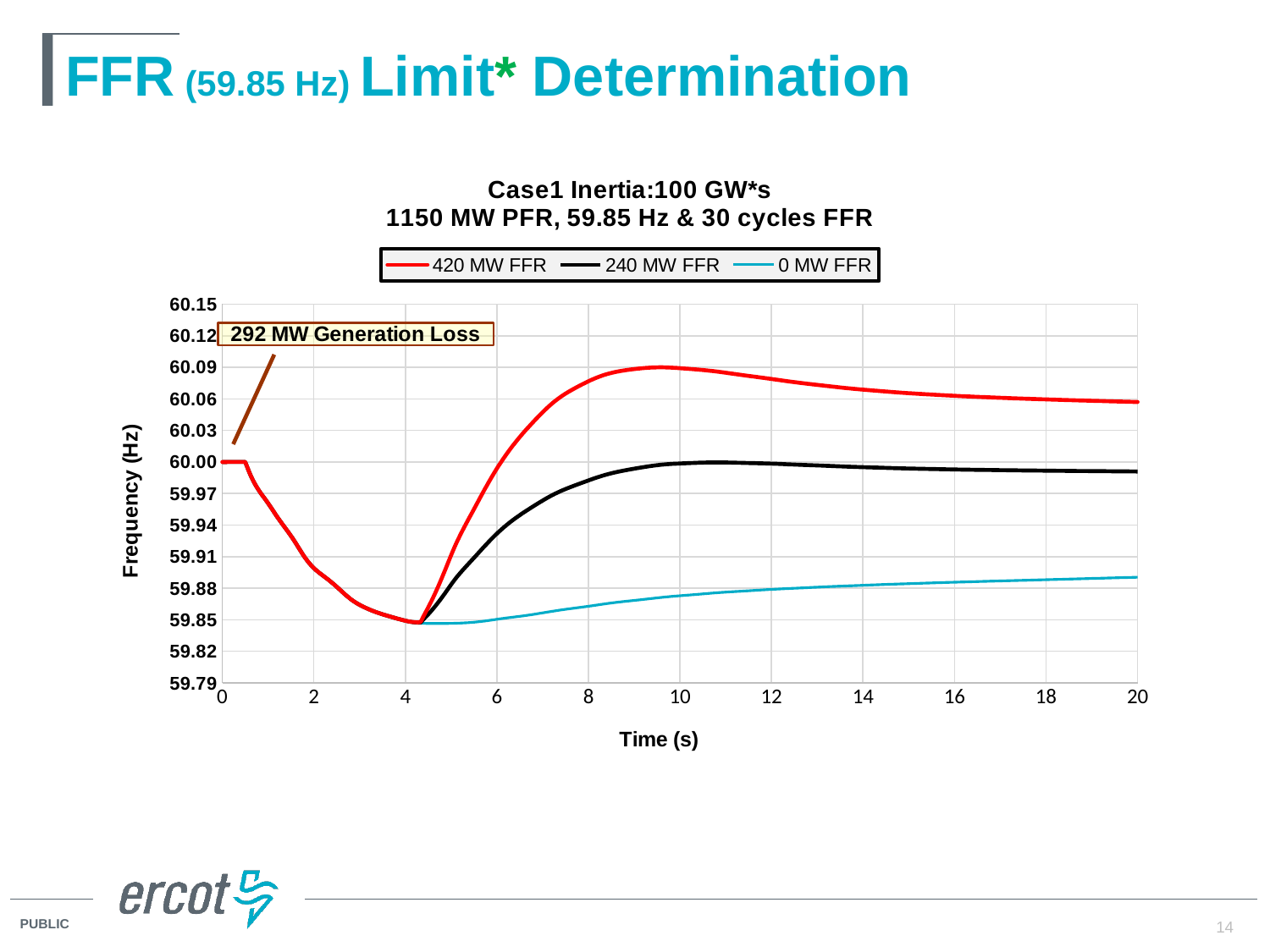
What are the three series named in the legend? 420 MW FFR, 240 MW FFR, 0 MW FFR Is the value of the 240 MW FFR series at time 20 s greater or less than 60.03? less Is the lowest point of the 420 MW FFR series greater or less than 59.88? less What text appears in the annotation box near the top left of the plot area? 292 MW Generation Loss Does the 0 MW FFR series rise or fall between time 6 s and time 20 s? rise What kind of chart is shown on the slide? line chart Is the value of the 420 MW FFR series at time 10 s greater or less than 60.06? greater How many series does the legend list? 3 Does the 420 MW FFR series rise or fall between time 10 s and time 20 s? fall At time 20 s, which series has the higher frequency, 420 MW FFR or 0 MW FFR? 420 MW FFR At time 8 s, which series has the higher frequency, 240 MW FFR or 0 MW FFR? 240 MW FFR